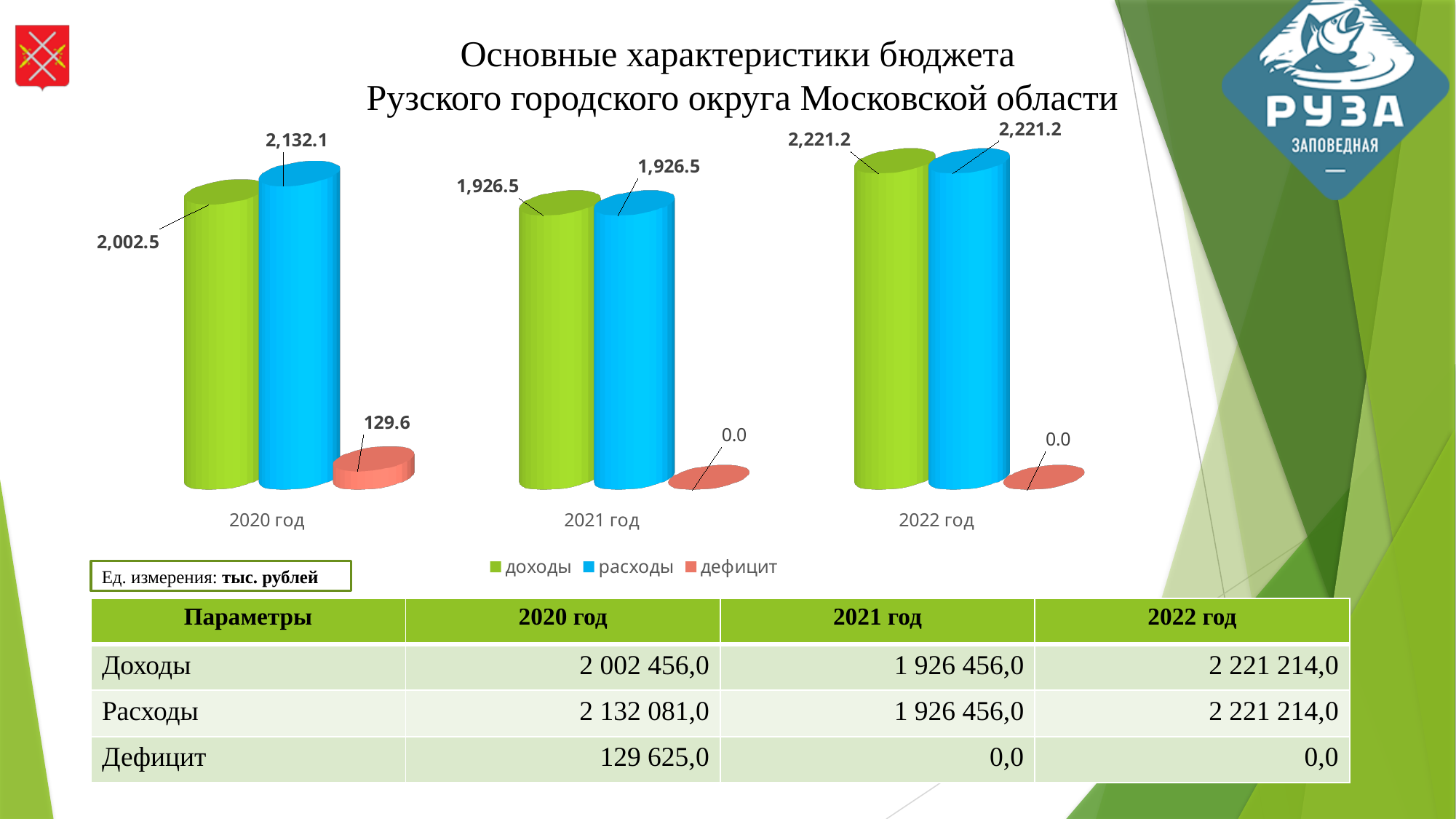
What is the value of дефицит for 2021 год? 0.0 What is the value of расходы for 2022 год? 2,221.2 What is the value of дефицит for 2020 год? 129.6 In which year is доходы the highest? 2022 год Which is larger for 2020 год, доходы or расходы? расходы What kind of chart is shown on the slide? bar chart In which year is расходы the lowest? 2021 год How many years (categories) are shown on the chart? 3 How many series does the legend list? 3 What is the value of расходы for 2020 год? 2,132.1 What is the value of доходы for 2020 год? 2,002.5 What is the difference between расходы and доходы for 2020 год? 129.6